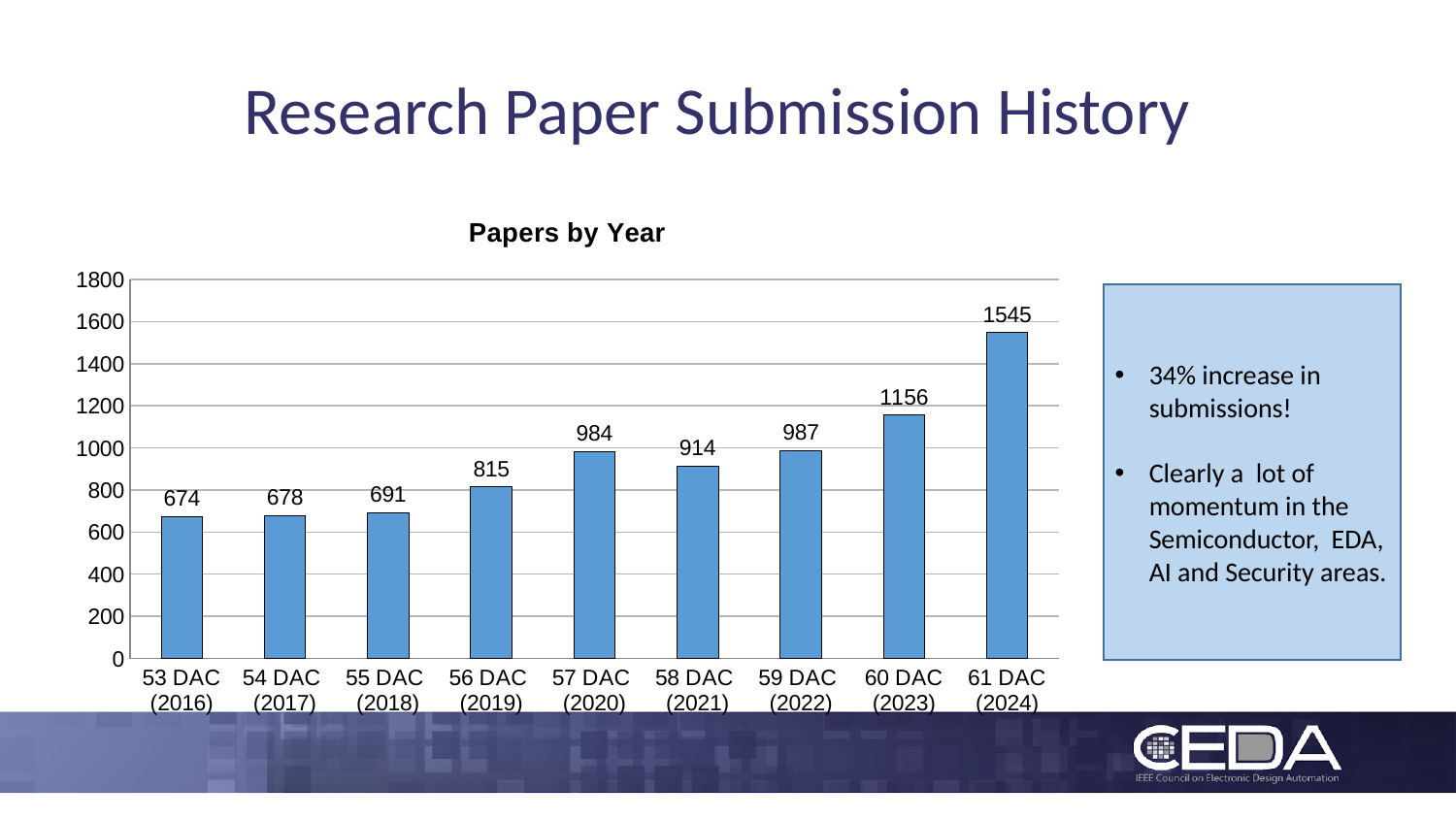
What kind of chart is shown on the slide? bar chart Which is larger, the value for 59 DAC (2022) or 57 DAC (2020)? 59 DAC (2022) What is the value for 56 DAC (2019)? 815 What is the difference between the values for 57 DAC (2020) and 58 DAC (2021)? 70 Is the value for 60 DAC (2023) greater or less than 1000? greater What is the difference between the values for 61 DAC (2024) and 60 DAC (2023)? 389 What is the title of the chart? Papers by Year What is the value for 58 DAC (2021)? 914 Which category has the lowest value? 53 DAC (2016) How many categories are shown on the x axis? 9 What is the value for 61 DAC (2024)? 1545 Which category has the highest value? 61 DAC (2024)